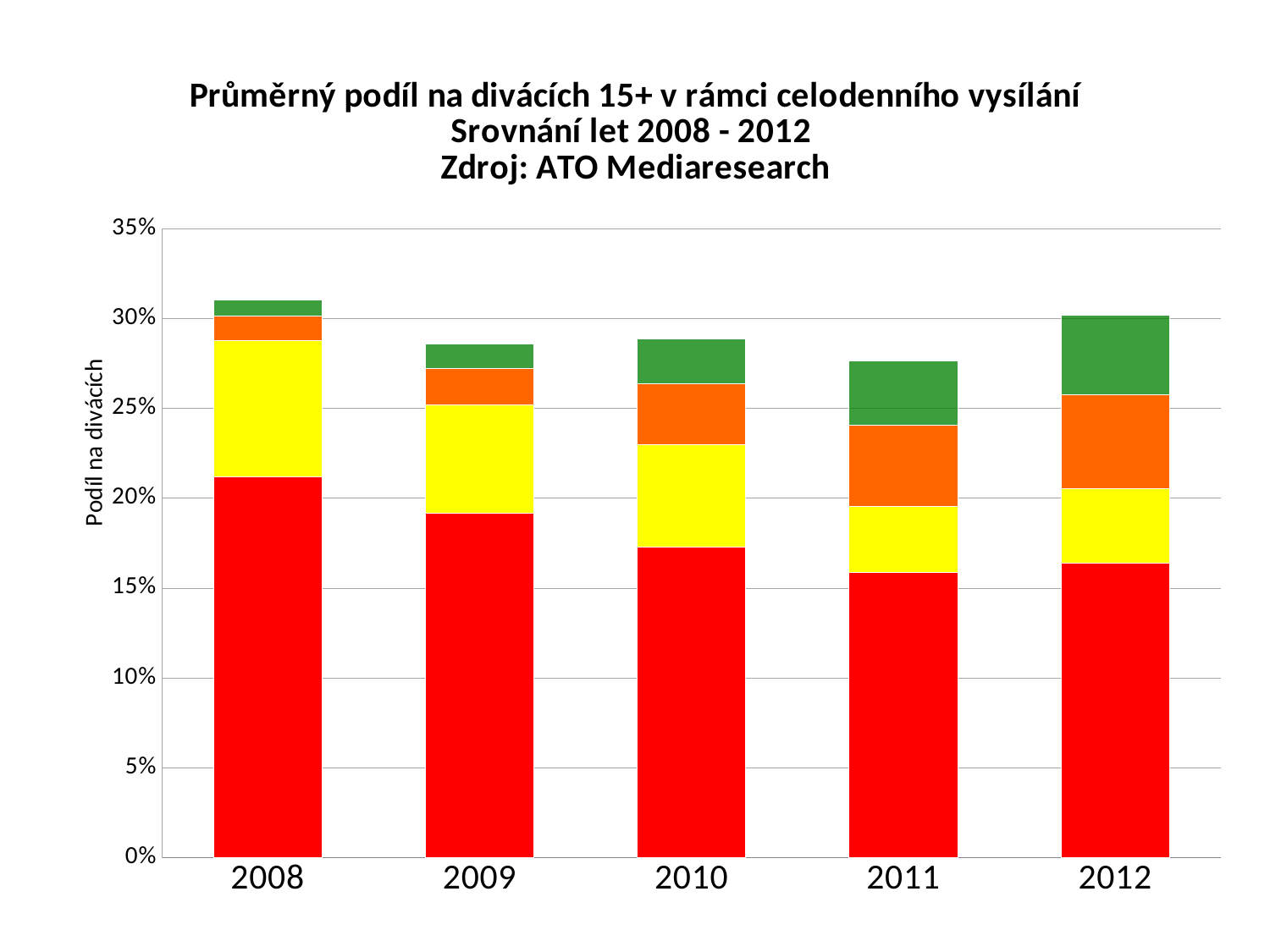
Is the red segment for 2008 greater or less than 20%? greater How many years are shown on the x axis of the chart? 5 Is the total height of the 2011 bar greater or less than 30%? less Is the red segment for 2008 larger or smaller than the red segment for 2011? larger Is the total height of the 2008 bar greater or less than 30%? greater Which year has the tallest green (top) segment? 2012 According to the chart title, what is the source of the data? ATO Mediaresearch What kind of chart is shown on the slide? stacked bar chart What is the label on the y axis of the chart? Podíl na divácích Which year has the tallest red (bottom) segment? 2008